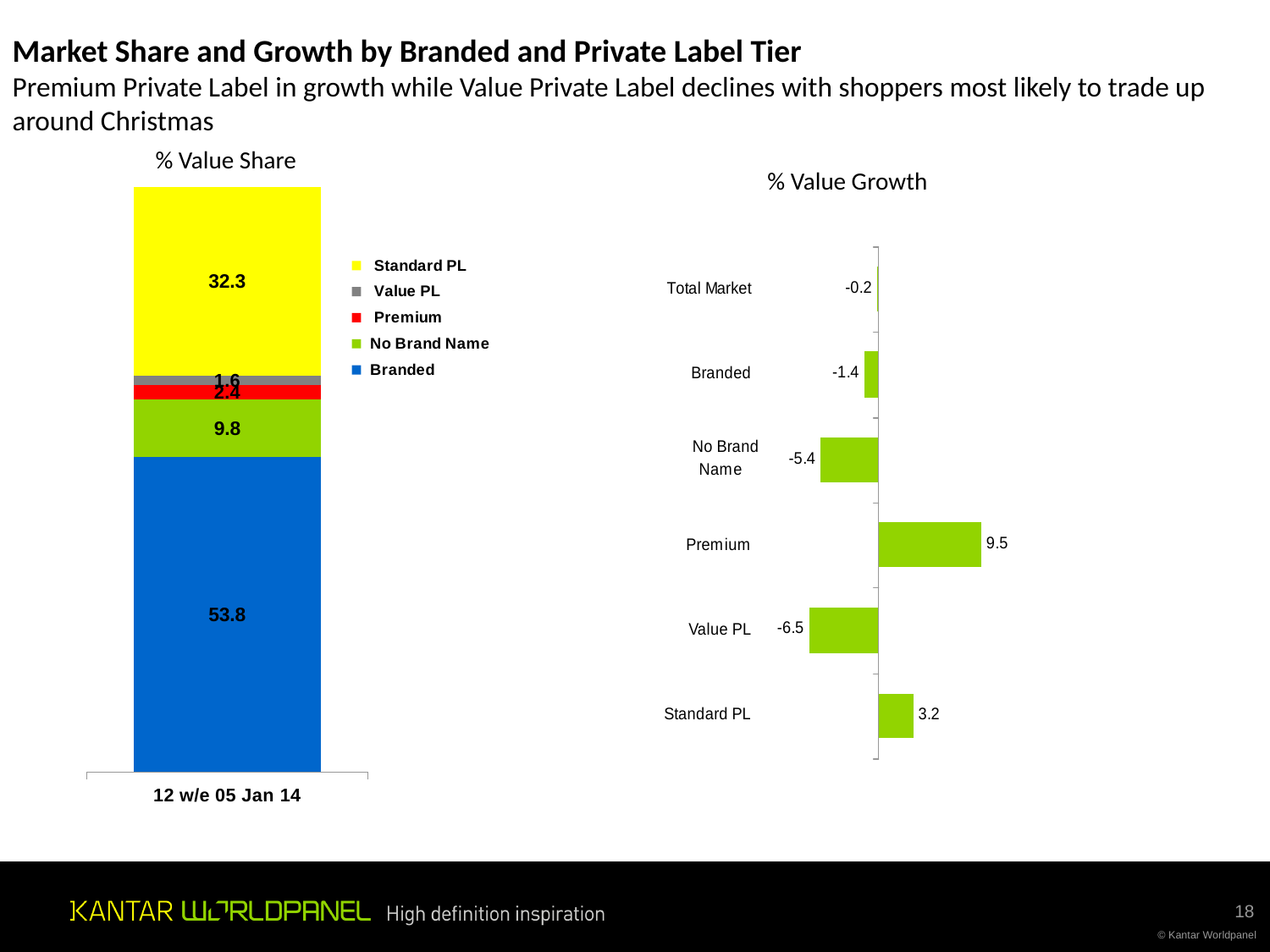
How many categories are shown in the % Value Growth chart? 6 In the % Value Growth chart, which category has the highest value growth? Premium In the % Value Growth chart, which category has the lowest value growth? Value PL In the % Value Growth chart, what is the value growth for Premium? 9.5 What kind of chart is the % Value Growth chart? Bar chart In the % Value Growth chart, what is the value growth for Value PL? -6.5 In the % Value Growth chart, which has the larger value growth, Branded or No Brand Name? Branded In the % Value Growth chart, what is the difference between the growth of Premium and Standard PL? 6.3 In the % Value Share chart, what is the share for Standard PL? 32.3 How many series does the legend of the % Value Share chart list? 5 In the % Value Growth chart, what is the value growth for Total Market? -0.2 In the % Value Share chart, what is the share for Branded? 53.8